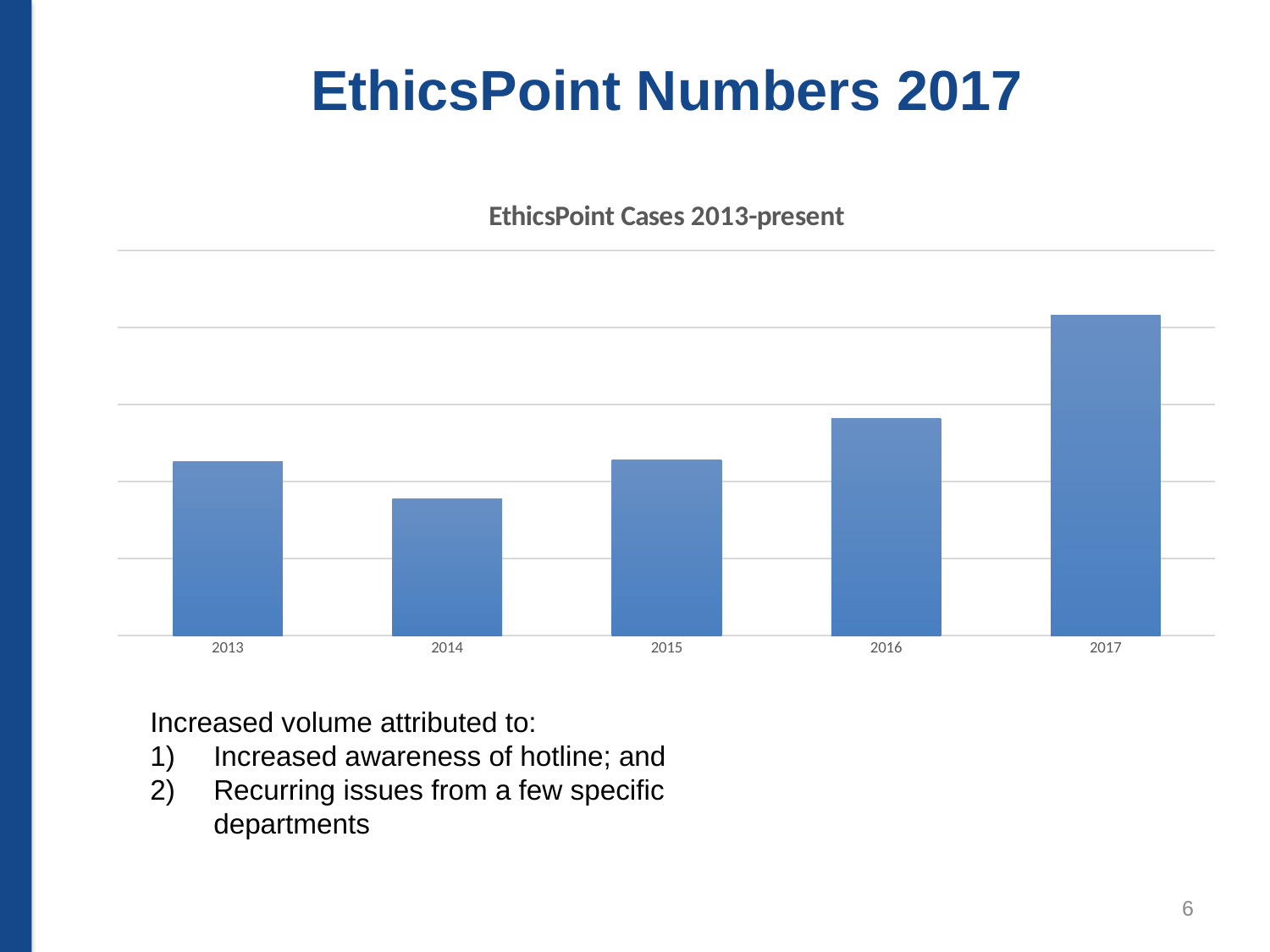
Which year has more EthicsPoint cases, 2016 or 2017? 2017 What is the title of the chart? EthicsPoint Cases 2013-present From 2014 to 2017, do the number of EthicsPoint cases rise or fall? rise Which year has more EthicsPoint cases, 2015 or 2016? 2016 Does the number of EthicsPoint cases rise or fall from 2013 to 2014? fall How many years are shown on the x axis of the chart? 5 What is the first year shown on the x axis of the chart? 2013 Which year has more EthicsPoint cases, 2013 or 2014? 2013 Which year has the lowest number of EthicsPoint cases? 2014 What type of chart is shown on the slide? bar chart Which year has the highest number of EthicsPoint cases? 2017